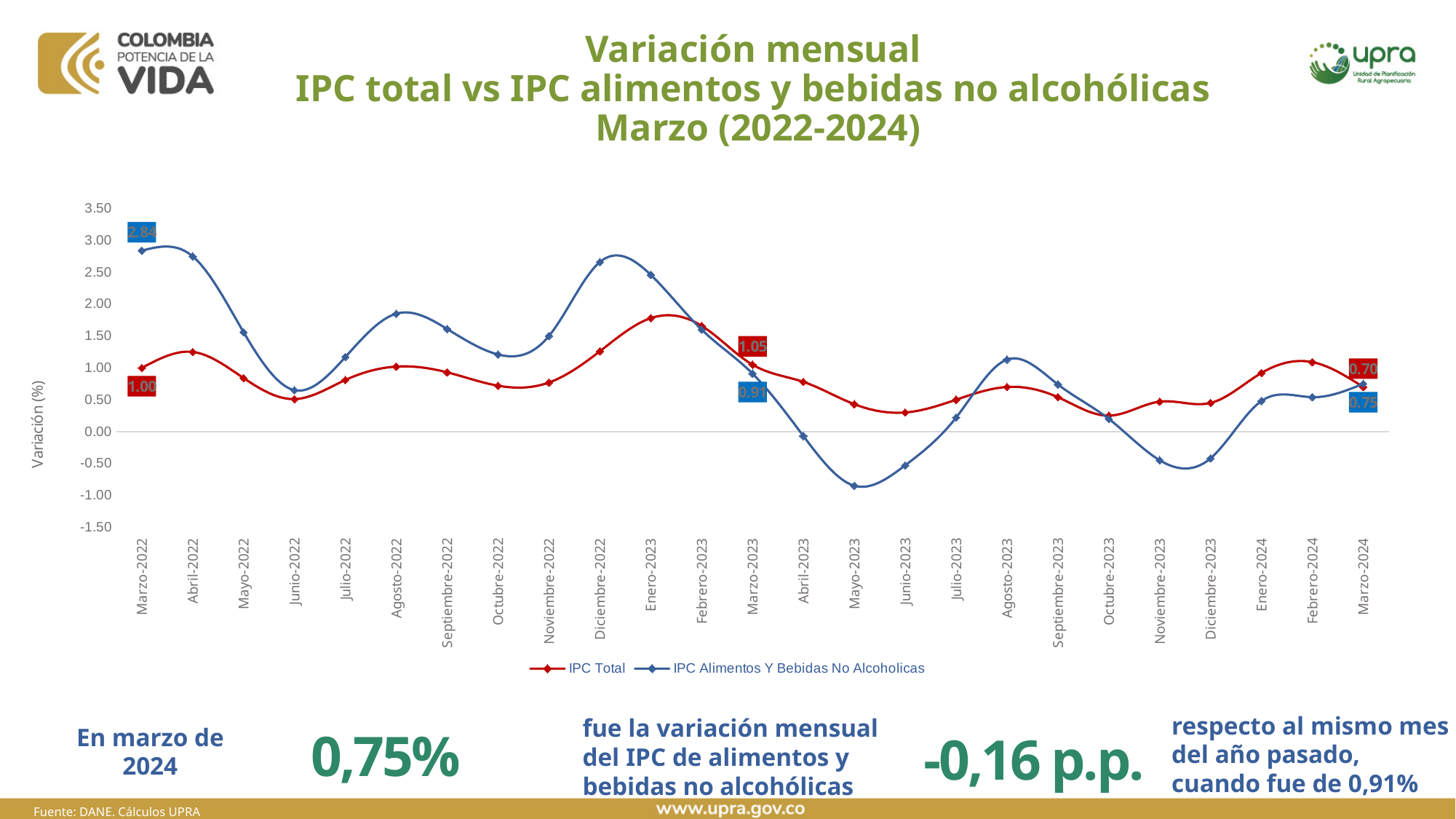
What is the value of IPC Alimentos Y Bebidas No Alcoholicas for Marzo-2024? 0.75 Is the value of IPC Alimentos Y Bebidas No Alcoholicas for Mayo-2023 greater or less than 0.00? less In which month does IPC Alimentos Y Bebidas No Alcoholicas reach its lowest value? Mayo-2023 How many months are plotted on the x axis? 25 What is the value of IPC Total for Marzo-2023? 1.05 Is the value of IPC Alimentos Y Bebidas No Alcoholicas for Diciembre-2022 greater or less than 2.50? greater What is the difference between IPC Alimentos Y Bebidas No Alcoholicas and IPC Total in Marzo-2022? 1.84 In Marzo-2023, which series has the higher value, IPC Total or IPC Alimentos Y Bebidas No Alcoholicas? IPC Total What kind of chart is shown on the slide? Line chart What is the value of IPC Alimentos Y Bebidas No Alcoholicas for Marzo-2022? 2.84 By how much did IPC Alimentos Y Bebidas No Alcoholicas change from Marzo-2023 (0.91) to Marzo-2024 (0.75)? -0.16 What is the value of IPC Total for Marzo-2022? 1.00